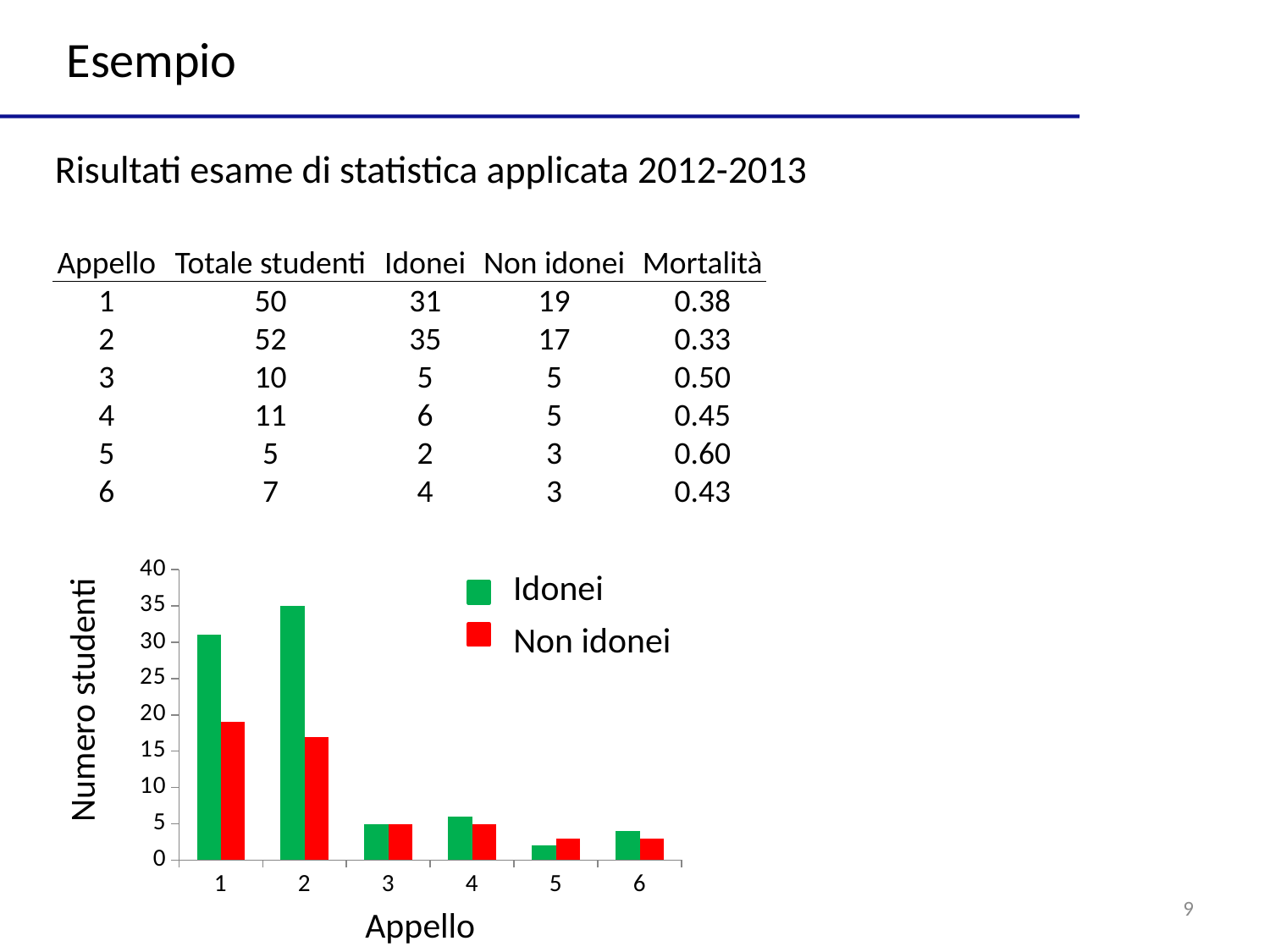
In the chart, which is larger for appello 5: Idonei or Non idonei? Non idonei In the chart, is the Idonei bar for appello 2 greater or less than 30? greater Which appello has the highest number of Non idonei students in the chart? 1 What is the number of Idonei students for appello 2? 35 In the chart, is the Non idonei bar for appello 1 greater or less than 20? less What colour represents the Non idonei series in the chart? red What kind of chart is shown on the slide? bar chart Which appello has the lowest number of Idonei students in the chart? 5 What is the difference between Idonei and Non idonei students for appello 1? 12 How many series does the chart legend list? 2 Which appello has the highest number of Idonei students in the chart? 2 How many appelli (categories) are shown on the x axis of the chart? 6